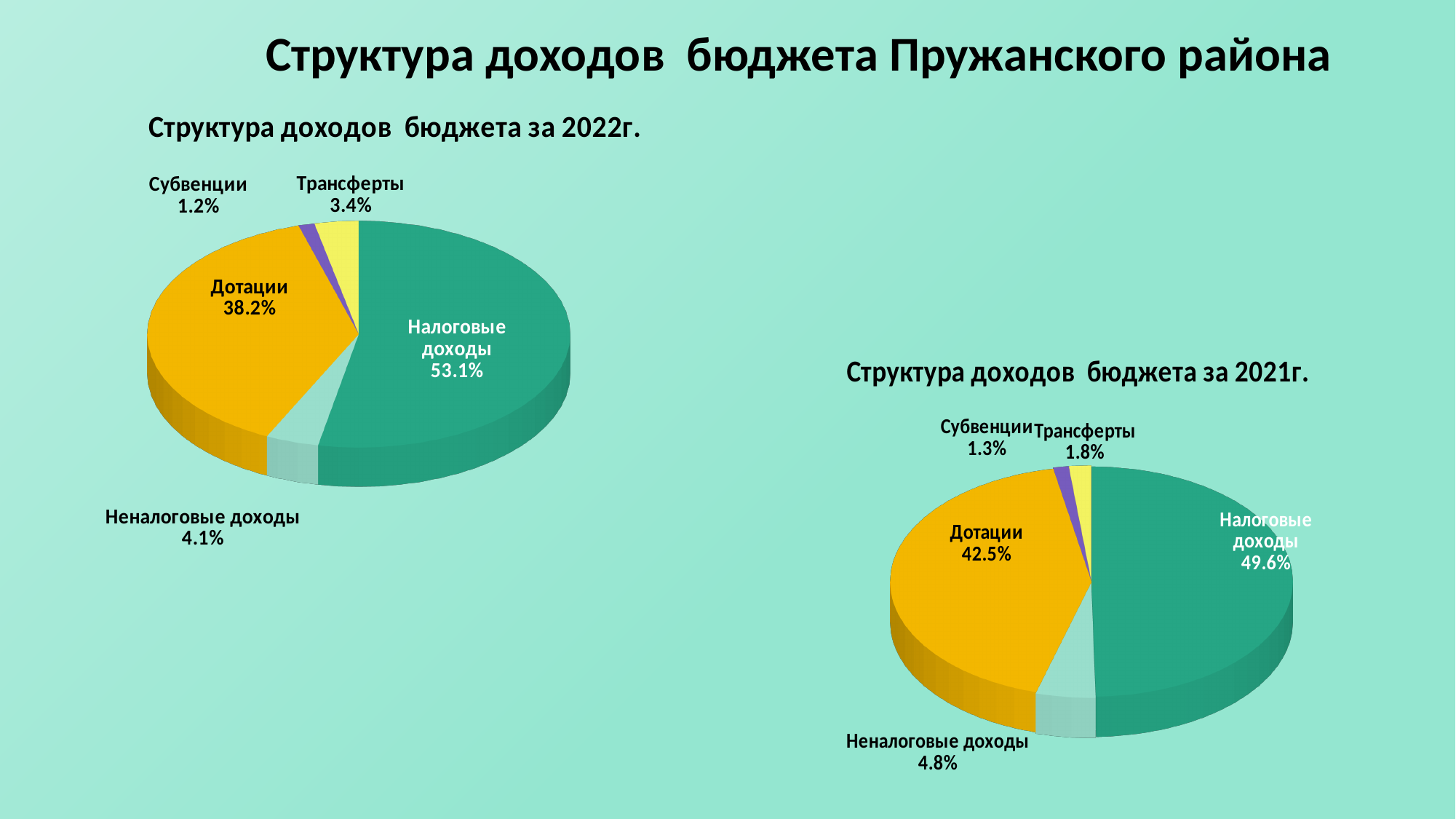
What type of chart is 'Структура доходов бюджета за 2022г.'? Pie chart In the chart 'Структура доходов бюджета за 2022г.', what is the value for Дотации? 38.2% In the chart 'Структура доходов бюджета за 2021г.', what is the value for Трансферты? 1.8% What is the title of the chart on the right side of the slide? Структура доходов бюджета за 2021г. How many categories does the chart 'Структура доходов бюджета за 2021г.' show? 5 In the chart 'Структура доходов бюджета за 2022г.', which category has the smallest share? Субвенции In the chart 'Структура доходов бюджета за 2021г.', which category has the largest share? Налоговые доходы In the chart 'Структура доходов бюджета за 2022г.', what share do Налоговые доходы have? 53.1% In the chart 'Структура доходов бюджета за 2022г.', what is the difference between Налоговые доходы and Дотации? 14.9% In the chart 'Структура доходов бюджета за 2021г.', what is the difference between Дотации and Неналоговые доходы? 37.7% In the chart 'Структура доходов бюджета за 2021г.', what is the value for Неналоговые доходы? 4.8% In the chart 'Структура доходов бюджета за 2022г.', which is larger: Трансферты or Неналоговые доходы? Неналоговые доходы